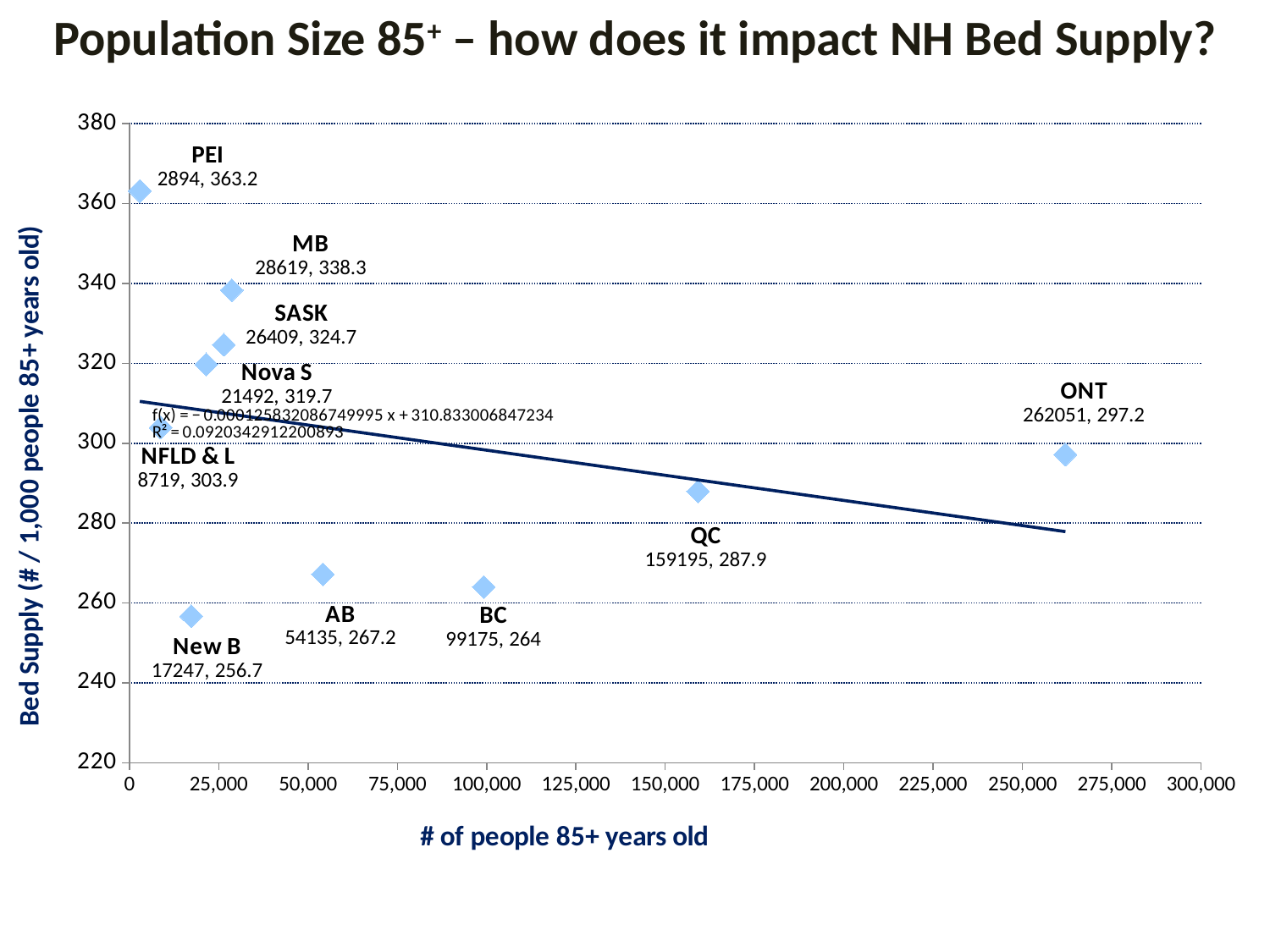
What is the difference in bed supply between ONT and QC? 9.3 What is the difference in bed supply between PEI and New B? 106.5 Which province has the highest bed supply? PEI Which has a higher bed supply, MB or SASK? MB What is the bed supply value for QC? 287.9 Does the fitted trend line rise or fall as the number of people 85+ increases? Falls How many provinces are plotted on the chart? 10 What kind of chart is shown on the slide? Scatter chart Which province has the lowest bed supply? New B Which province has the largest number of people 85+ years old? ONT How many people 85+ years old are shown for ONT? 262051 What is the bed supply value for PEI? 363.2